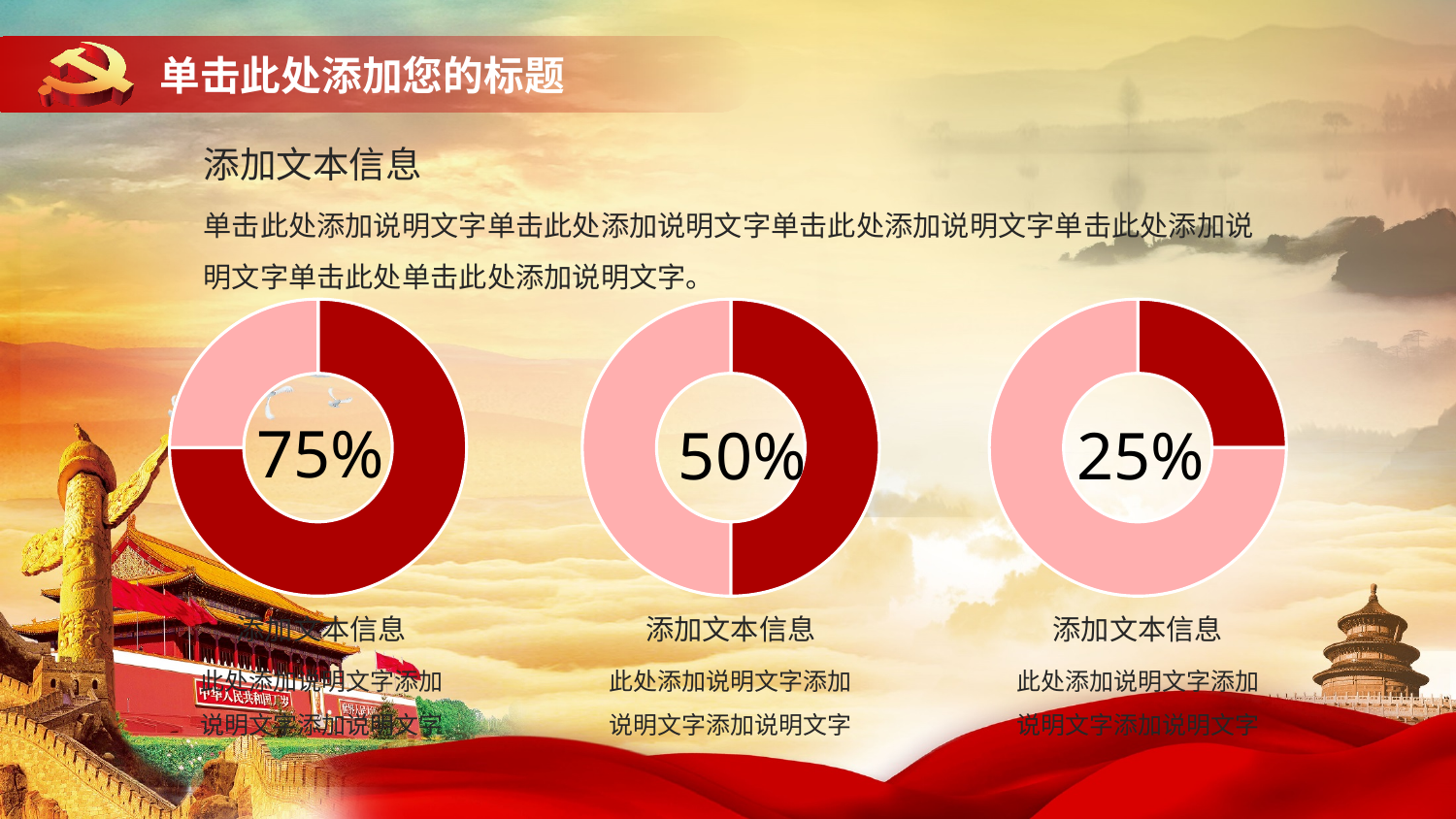
Which of the three donut charts shows the lowest percentage: left, middle, or right? right In the right donut chart, what share of the ring is filled with the dark red colour? 25% What is the difference between the percentage in the left donut chart and the percentage in the right donut chart? 50% What is the difference between the percentage in the left donut chart and the percentage in the middle donut chart? 25% What percentage is shown in the center of the right donut chart? 25% Is the percentage in the middle donut chart larger or smaller than the percentage in the right donut chart? larger What two colours are used for the segments of the donut charts? dark red and light pink What percentage is shown in the center of the left donut chart? 75% What kind of chart is used three times on this slide? donut chart Which of the three donut charts shows the highest percentage: left, middle, or right? left What percentage is shown in the center of the middle donut chart? 50% How many donut charts are on the slide? 3